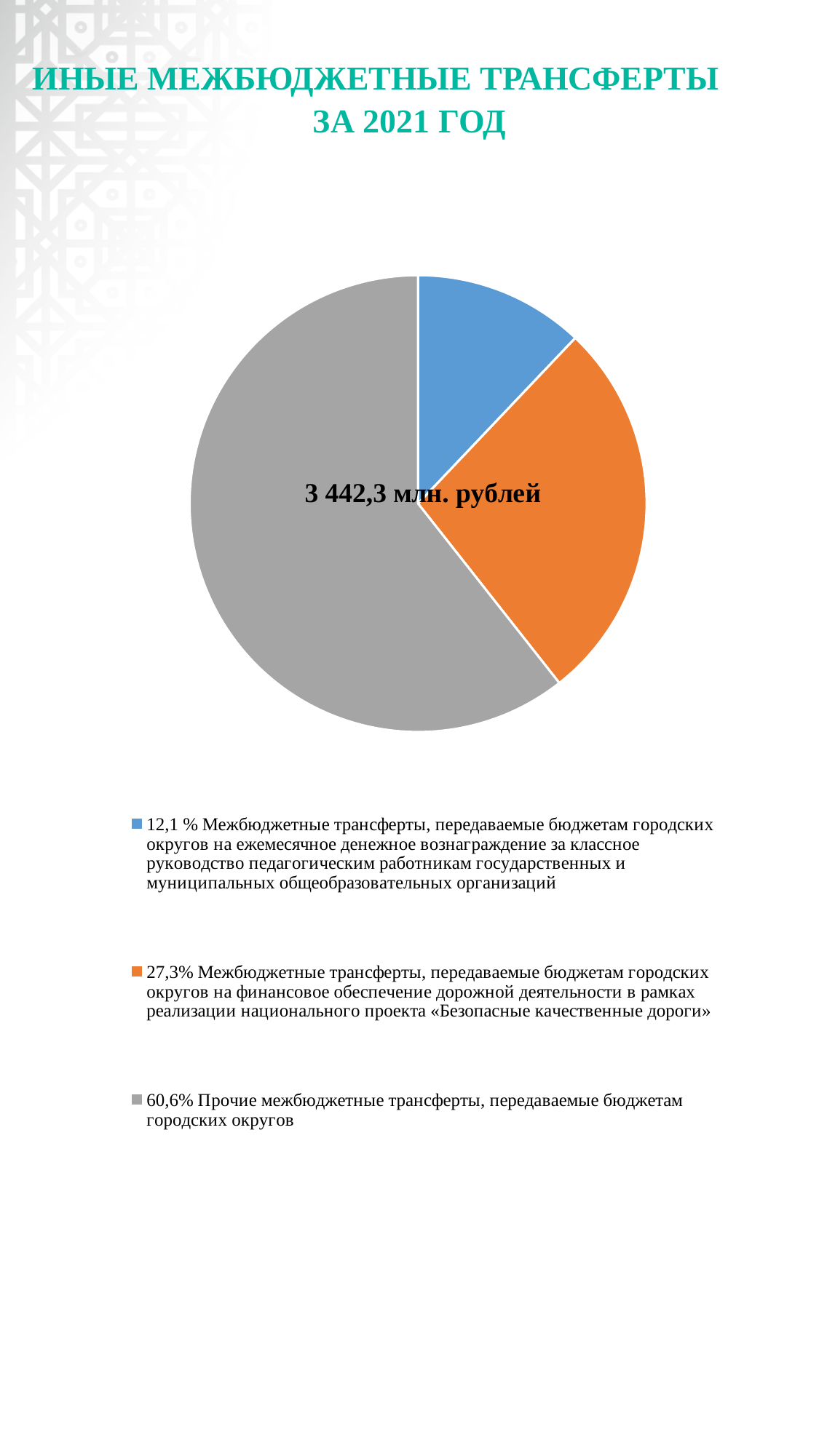
Which is larger: the share for road activity transfers or the share for classroom leadership remuneration transfers? Road activity transfers (27,3%) What share of the pie is the transfers for road activity under the national project «Безопасные качественные дороги»? 27,3% What share of the pie is the transfers for monthly remuneration for classroom leadership to teachers? 12,1 % What colour is the slice for 'Прочие межбюджетные трансферты, передаваемые бюджетам городских округов'? Grey What total amount is printed in the centre of the pie chart? 3 442,3 млн. рублей What kind of chart is shown on the slide? Pie chart How many entries does the legend list? 3 How many slices does the pie chart have? 3 What is the difference in percentage points between the 'Прочие межбюджетные трансферты' share and the road activity transfers share? 33,3 What share of the pie is 'Прочие межбюджетные трансферты, передаваемые бюджетам городских округов'? 60,6% Which category has the largest share of the pie? Прочие межбюджетные трансферты, передаваемые бюджетам городских округов